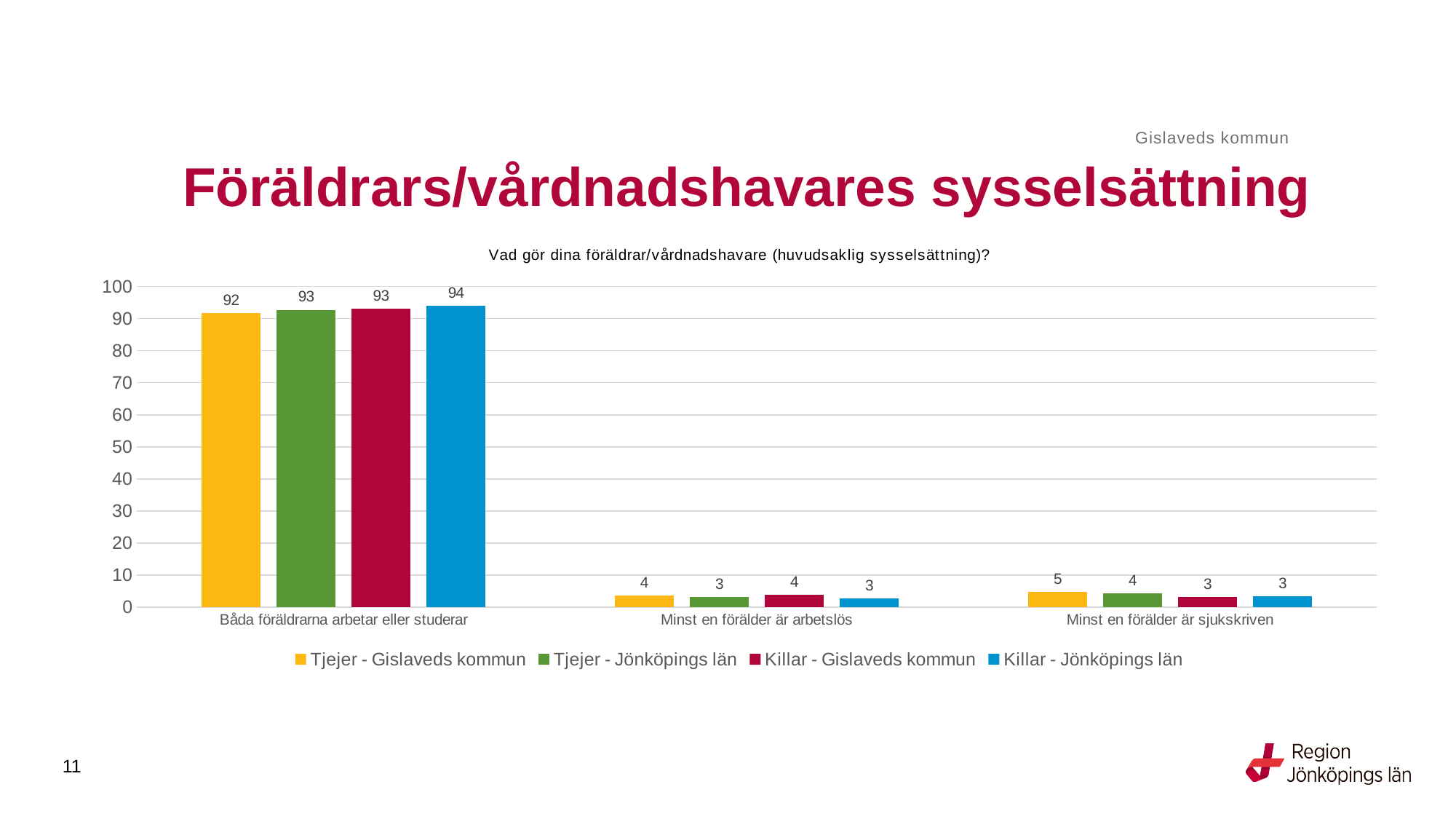
What is the value for Tjejer - Gislaveds kommun in the category 'Båda föräldrarna arbetar eller studerar'? 92 What is the value for Killar - Gislaveds kommun in the category 'Minst en förälder är arbetslös'? 4 Which series has the highest value in the category 'Båda föräldrarna arbetar eller studerar'? Killar - Jönköpings län What is the difference between the Killar - Jönköpings län value and the Tjejer - Gislaveds kommun value in the category 'Båda föräldrarna arbetar eller studerar'? 2 What is the question text shown as the chart title? Vad gör dina föräldrar/vårdnadshavare (huvudsaklig sysselsättning)? What is the value for Tjejer - Gislaveds kommun in the category 'Minst en förälder är sjukskriven'? 5 Is the value for Tjejer - Jönköpings län in 'Båda föräldrarna arbetar eller studerar' greater or less than 90? greater How many series does the legend list? 4 Which series has the lowest value in the category 'Båda föräldrarna arbetar eller studerar'? Tjejer - Gislaveds kommun How many categories are shown on the x axis? 3 What kind of chart is shown on the slide? bar chart What is the value for Killar - Jönköpings län in the category 'Båda föräldrarna arbetar eller studerar'? 94